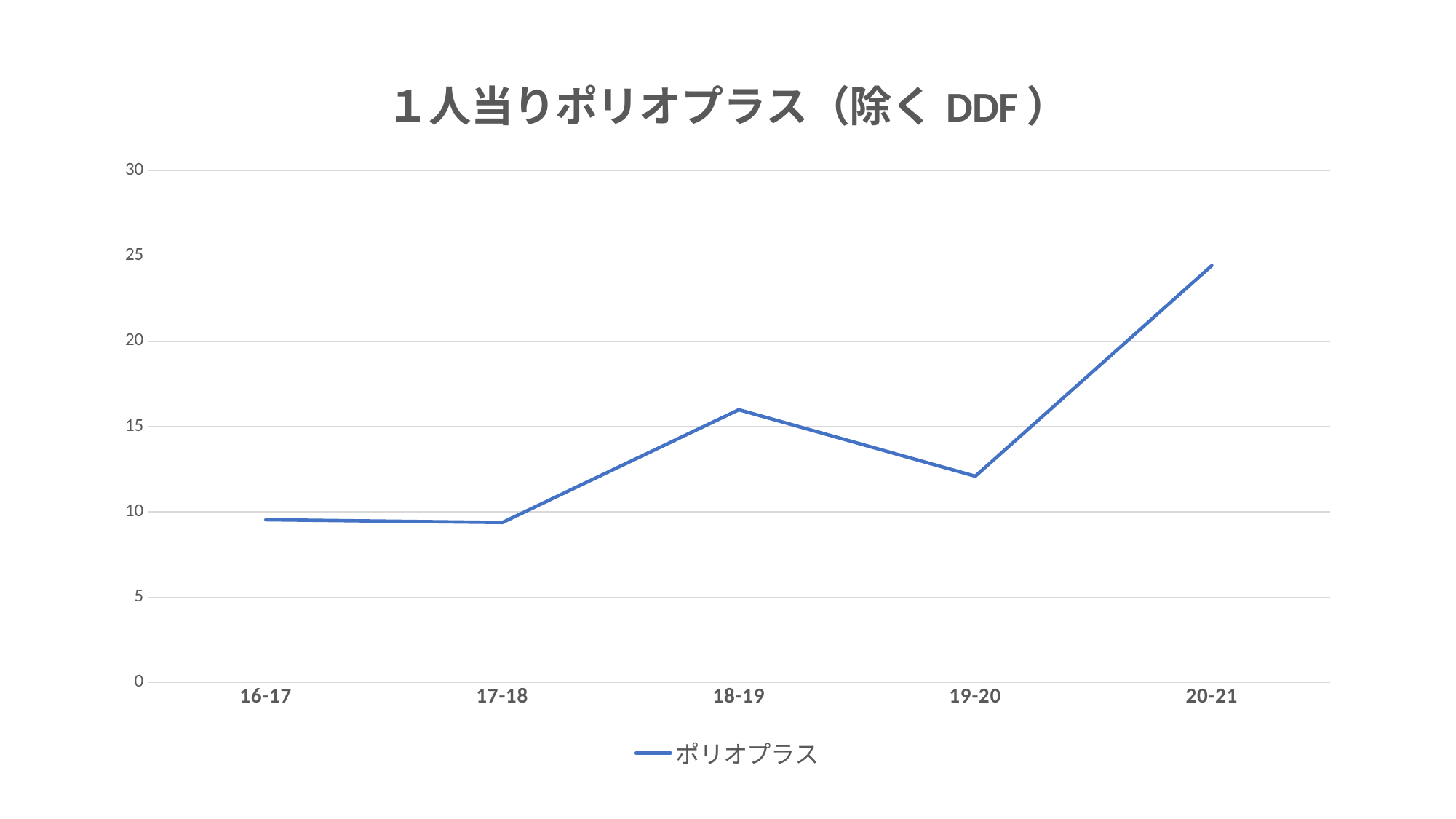
What is the name of the series shown in the legend? ポリオプラス Which period has the highest value for ポリオプラス? 20-21 Is the value for 16-17 greater or less than 10? less Is the value for 18-19 greater or less than 15? greater Is the value for 20-21 greater or less than 20? greater Which is larger, the value for 18-19 or the value for 19-20? 18-19 How many periods are plotted along the x axis? 5 What kind of chart is shown on the slide? line chart What is the title of the chart? １人当りポリオプラス（除く DDF） How many series does the legend list? 1